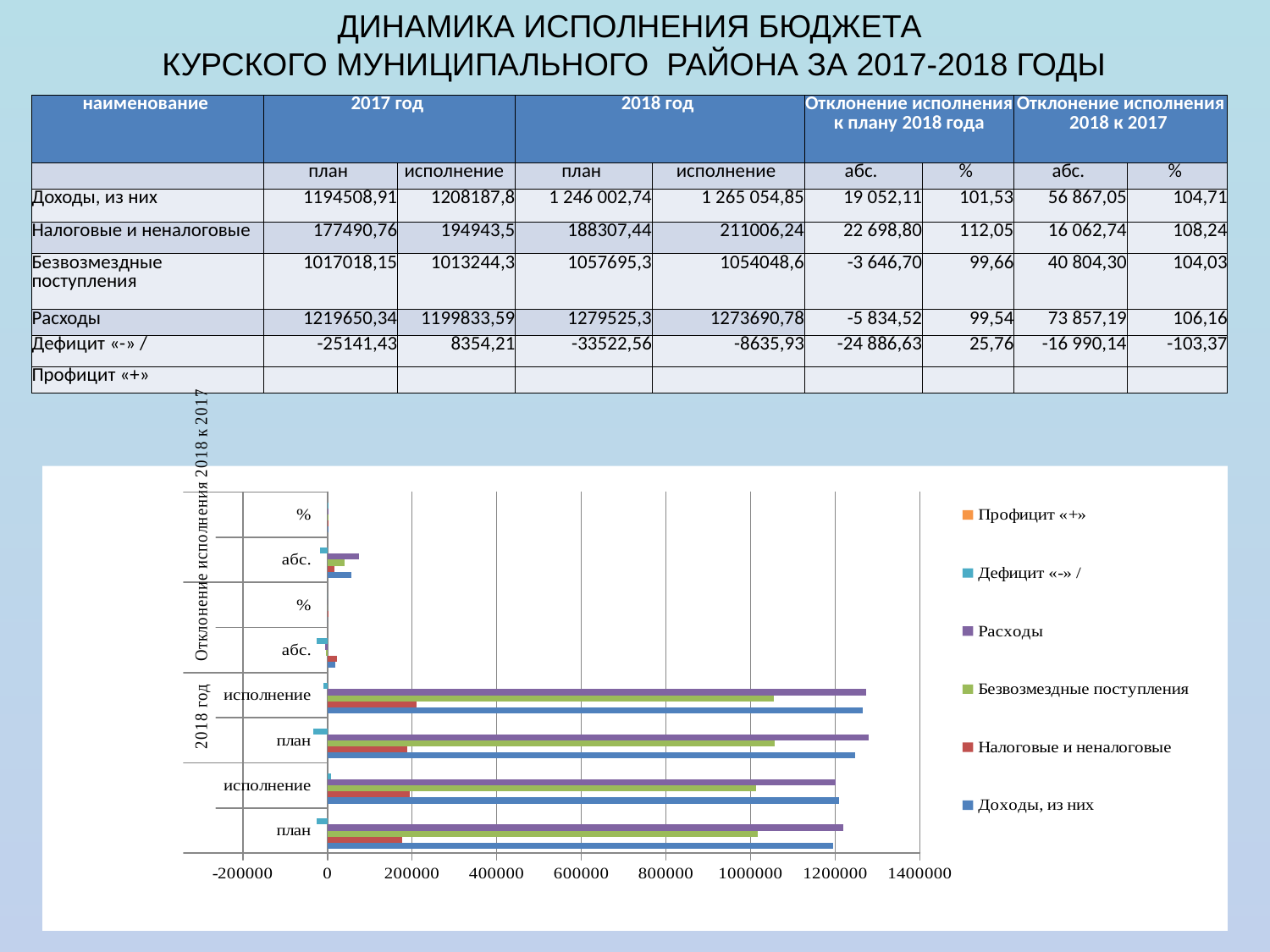
Is the value for Налоговые и неналоговые in the 2018 год исполнение category greater or less than 200000? greater Which series is shown in green in the chart legend? Безвозмездные поступления Is the value for Доходы, из них in the 2017 план category greater or less than 1200000? less In the 2018 год план category, which is larger: Безвозмездные поступления or Налоговые и неналоговые? Безвозмездные поступления What kind of chart is shown on the slide? bar chart According to the table, what is the 2018 исполнение value for Расходы plotted in the chart? 1273690,78 Is the value for Расходы in the 2018 год план category greater or less than 1200000? greater How many category groups are shown along the vertical axis of the chart? 8 In the 2017 план category, which series has the lowest value? Дефицит «-» / How many series does the chart legend list? 6 Which series is shown in purple in the chart legend? Расходы